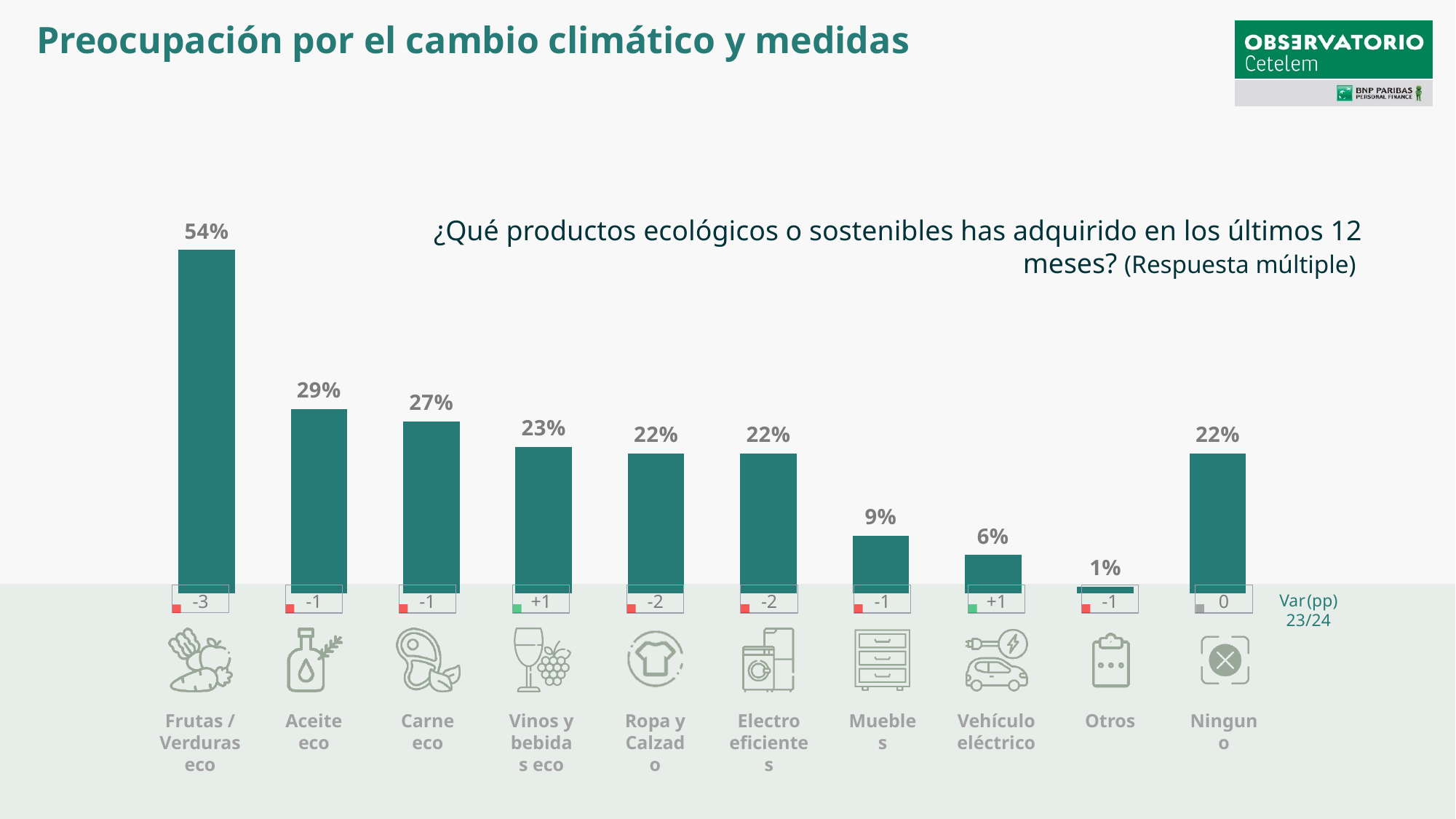
What is the value shown for Vehículo eléctrico? 6% Which category has the highest value? Frutas / Verduras eco What kind of chart is shown on the slide? Bar chart What percentage of respondents acquired Frutas / Verduras eco in the last 12 months? 54% Which category has the lowest value? Otros What is the difference between the values for Carne eco and Muebles? 18 percentage points How many categories are shown in the chart? 10 Which is larger, the value for Aceite eco or the value for Vinos y bebidas eco? Aceite eco What is the Var(pp) 23/24 value shown for Ropa y Calzado? -2 What is the difference between the values for Frutas / Verduras eco and Aceite eco? 25 percentage points What is the value shown for Ninguno? 22% Which categories show a positive Var(pp) 23/24 change? Vinos y bebidas eco and Vehículo eléctrico